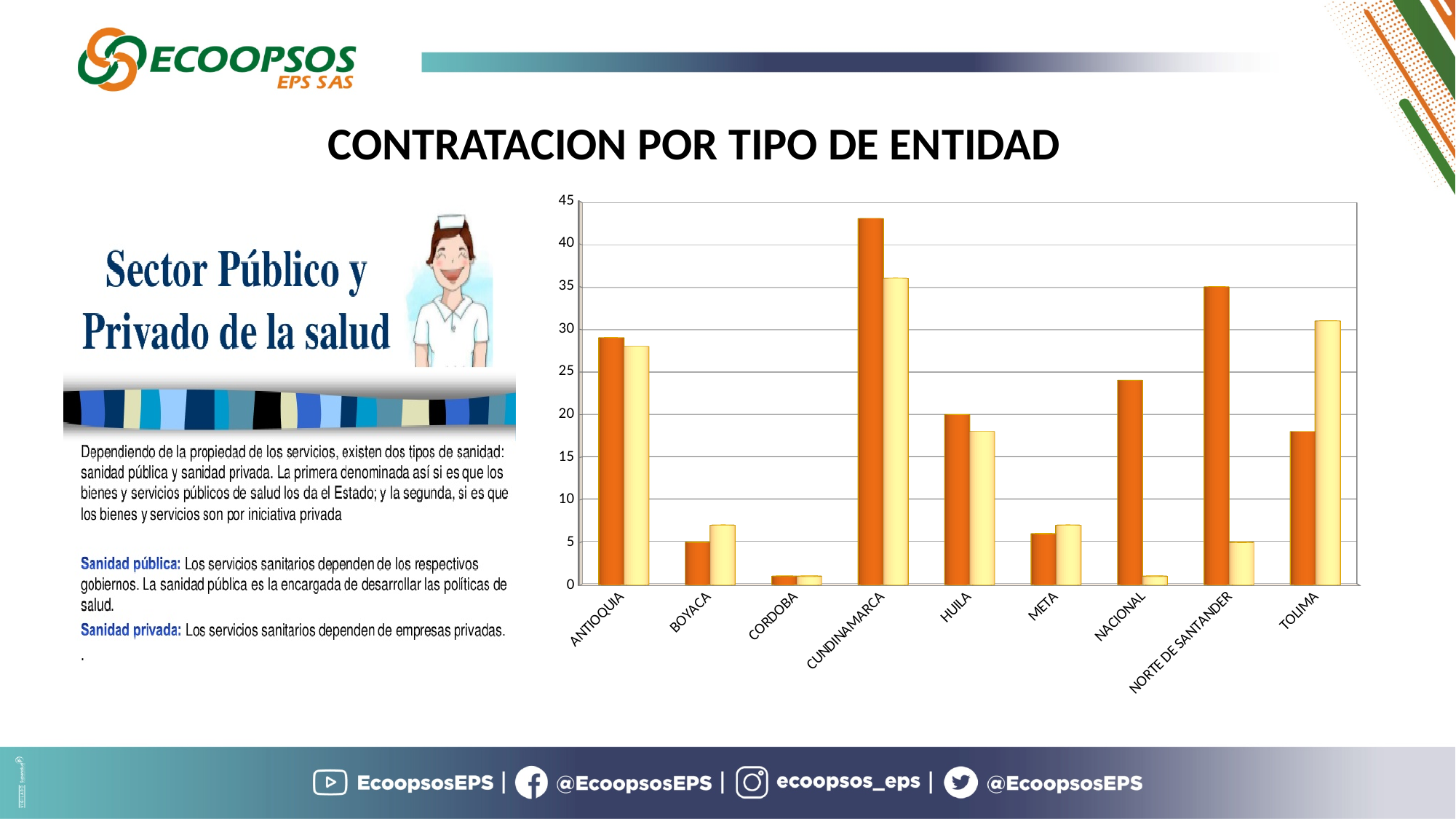
What is the title shown above the chart on the slide? CONTRATACION POR TIPO DE ENTIDAD What kind of chart is shown on the slide? Bar chart How many categories are shown along the x axis of the chart? 9 Is the orange bar for ANTIOQUIA greater or less than 25? greater For TOLIMA, which bar is taller, the orange one or the yellow one? The yellow one Which category has the tallest orange bar? CUNDINAMARCA Which category has the shortest orange bar? CORDOBA For NACIONAL, which bar is taller, the orange one or the yellow one? The orange one Is the orange bar for CUNDINAMARCA greater or less than 40? greater Is the yellow bar for NORTE DE SANTANDER greater or less than 10? less Which category has the tallest yellow bar? CUNDINAMARCA